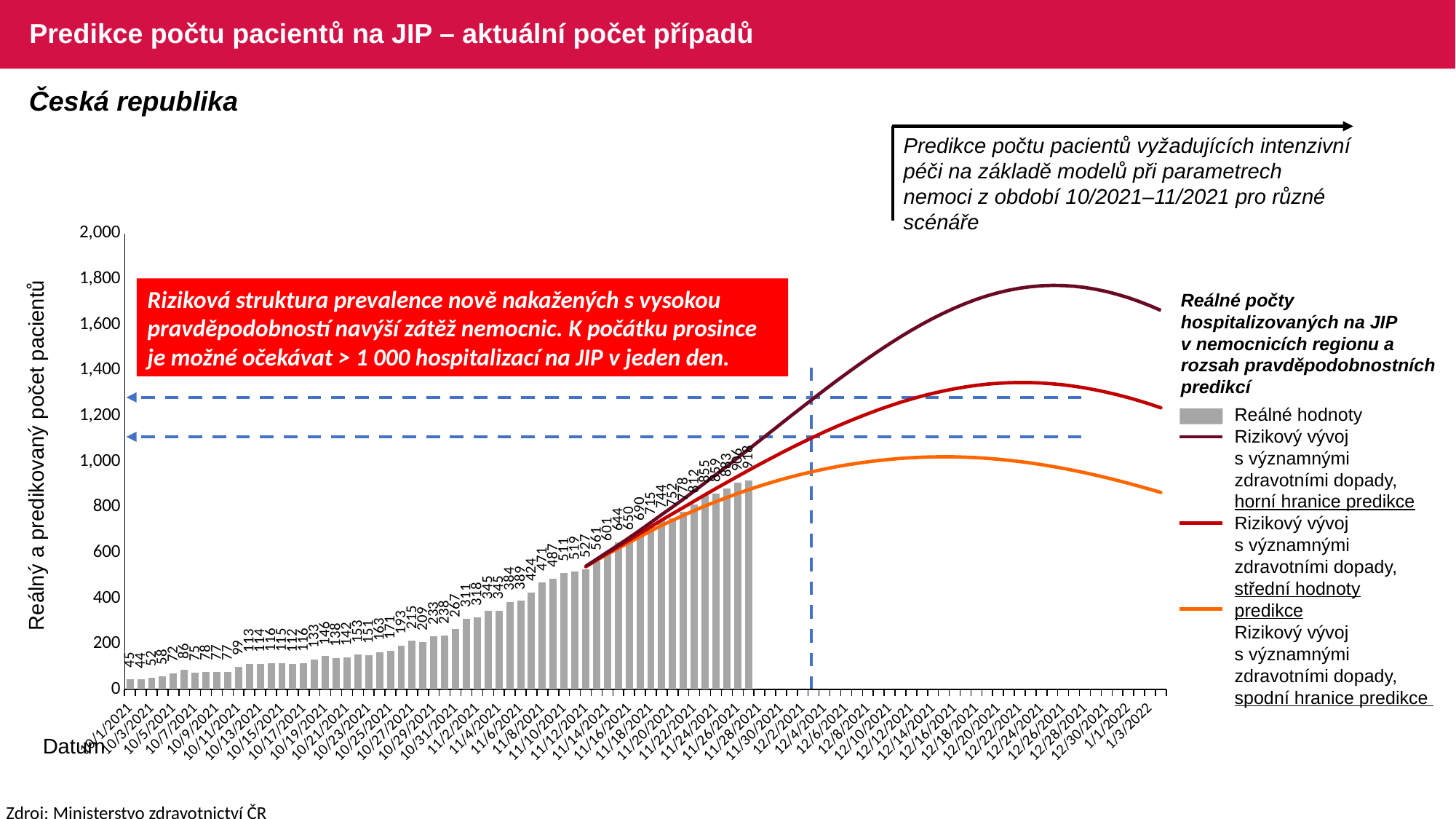
How many series does the legend list? 4 What kind of chart is shown on the slide? A combined bar and line chart Is the peak of the 'střední hodnoty predikce' line greater or less than 1,400? less Do the bar values (Reálné hodnoty) rise or fall from 10/1/2021 to the end of November 2021? Rise What is the value of the first bar, for 10/1/2021? 45 Is the peak of the 'spodní hranice predikce' line greater or less than 1,200? less Is the peak of the 'horní hranice predikce' line greater or less than 1,600? greater What is the highest value shown on the y axis? 2,000 Which prediction line reaches the highest peak? Horní hranice predikce What is the label of the y axis? Reálný a predikovaný počet pacientů Which prediction line reaches the lowest peak? Spodní hranice predikce Which series is shown as grey bars? Reálné hodnoty